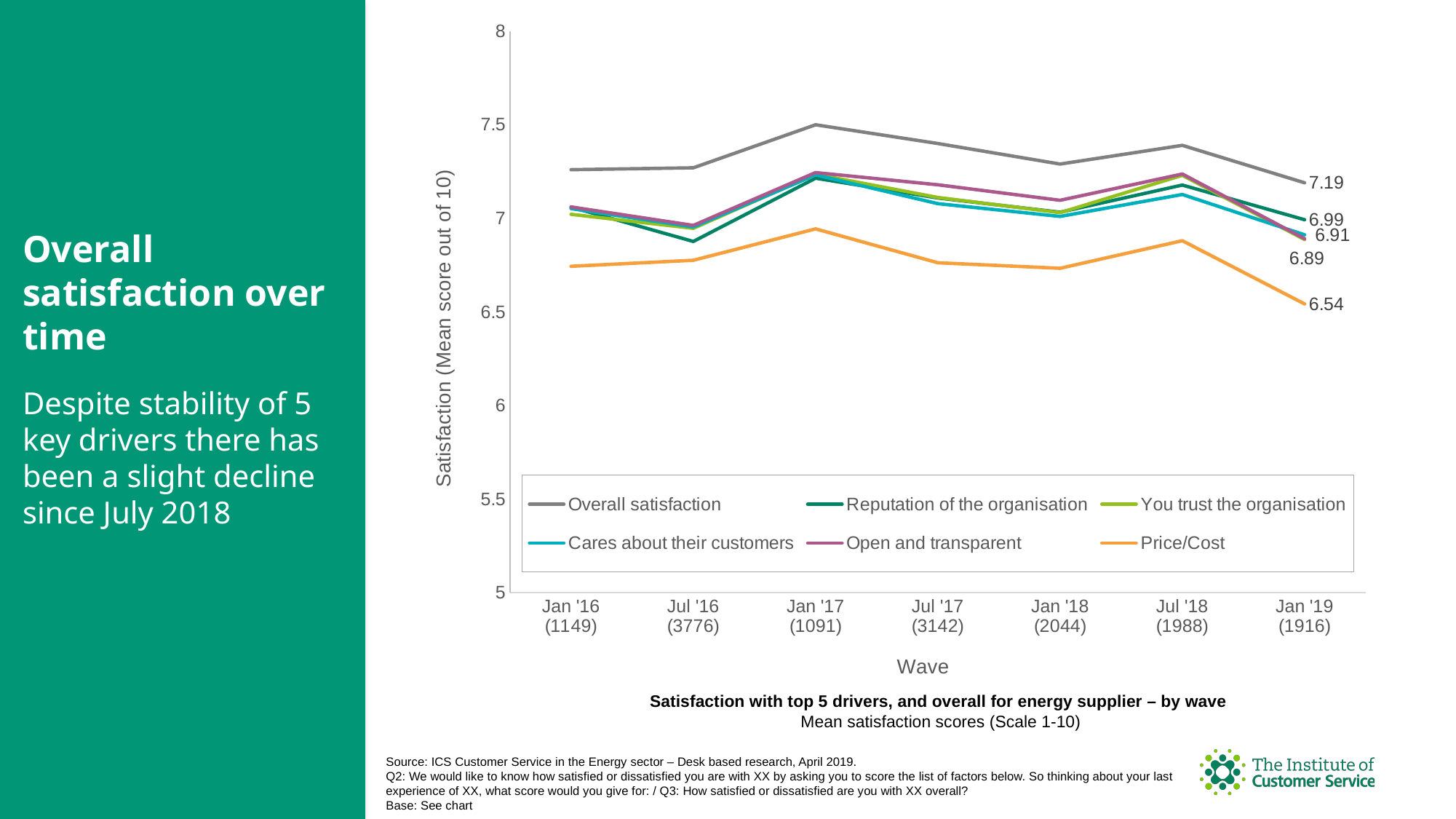
What is the Reputation of the organisation score at Jan '19? 6.99 Does Overall satisfaction rise or fall from Jul '18 to Jan '19? fall Is the Overall satisfaction value at Jan '17 greater or less than 7? greater Which series has the highest value at Jan '19? Overall satisfaction How many waves are plotted along the x axis? 7 What kind of chart is shown on the slide? line chart Which series has the lowest value at Jan '19? Price/Cost What is the base size shown for the Jul '16 wave? 3776 What is the difference between Overall satisfaction and Price/Cost at Jan '19? 0.65 What is the Overall satisfaction score at Jan '19? 7.19 What is the Price/Cost score at Jan '19? 6.54 How many series does the legend list? 6